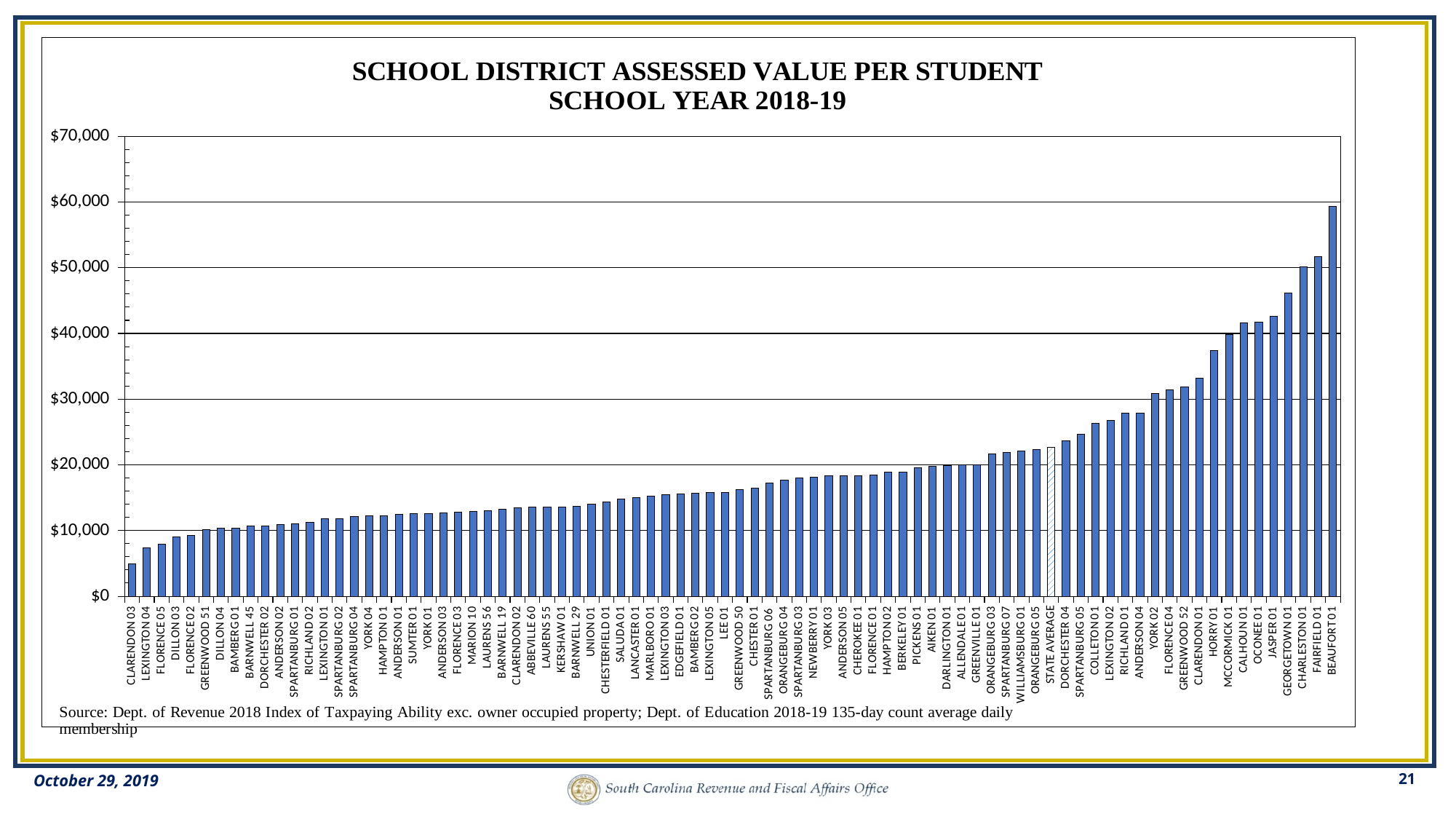
Do the bar values rise or fall moving from left to right along the x axis? rise Is the value for BEAUFORT 01 greater or less than $50,000? greater Is the value for CLARENDON 03 greater or less than $10,000? less Which is larger, the value for BEAUFORT 01 or the value for CHARLESTON 01? BEAUFORT 01 Which school district has the lowest assessed value per student? CLARENDON 03 Is the value for STATE AVERAGE greater or less than $20,000? greater What is the title of the chart? SCHOOL DISTRICT ASSESSED VALUE PER STUDENT SCHOOL YEAR 2018-19 Which school district has the highest assessed value per student? BEAUFORT 01 What is the highest value shown on the y axis? $70,000 What kind of chart is shown on the slide? bar chart